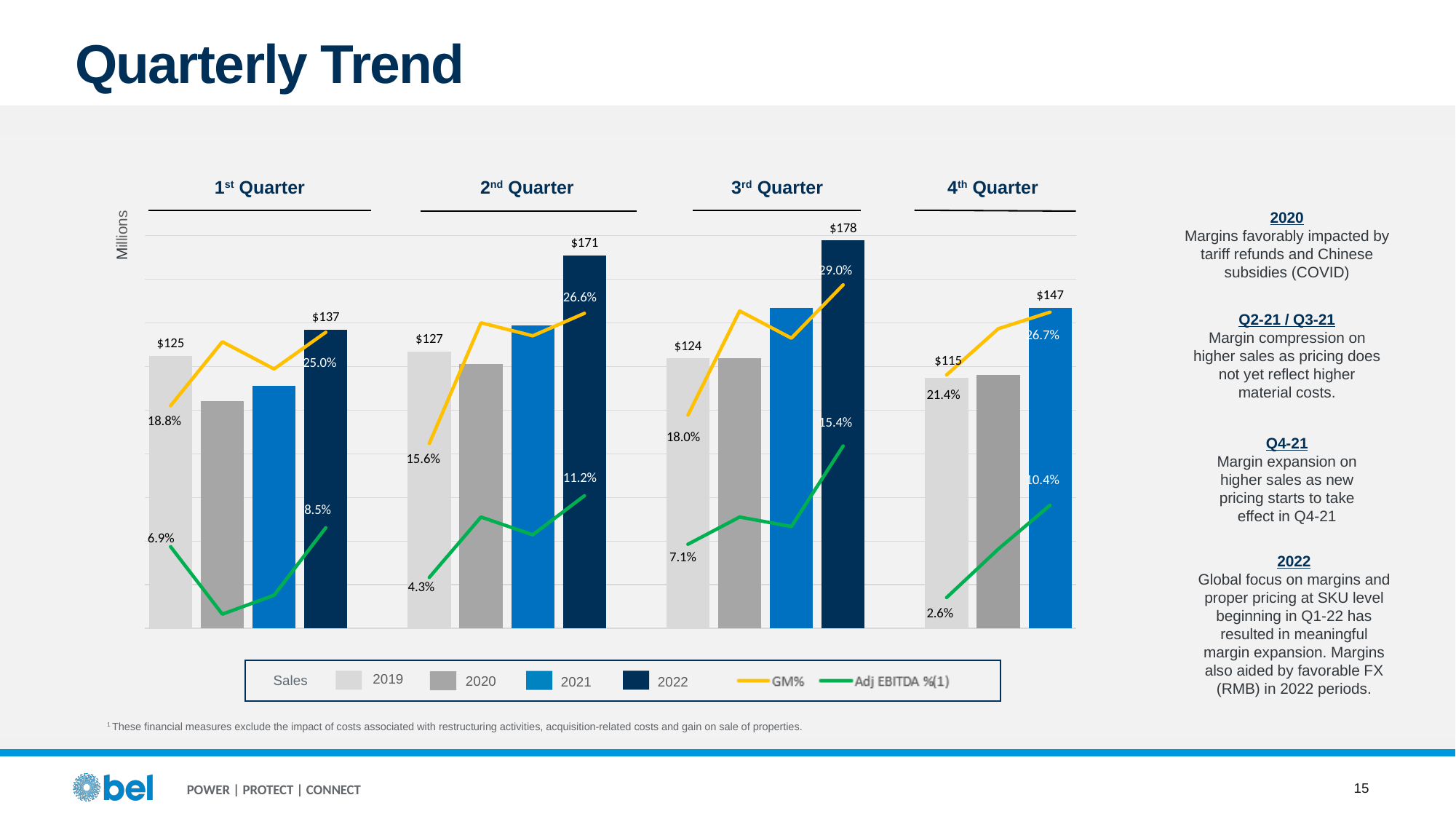
In the 2nd Quarter chart, what is the GM% value labelled on the 2022 bar? 26.6% In the 2nd Quarter chart, what is the difference between the 2022 sales ($171) and the 2019 sales ($127)? $44 How many entries does the legend list in total? 6 In the 3rd Quarter chart, what is the 2019 sales value? $124 Across all four quarter charts, which labelled sales value is the highest? $178 (3rd Quarter, 2022) How many sales bars are shown in the 4th Quarter chart? 3 In the 3rd Quarter chart, does the GM% line rise or fall from 2019 to 2022? rise In the 1st Quarter chart, which is larger: the 2019 sales bar or the 2022 sales bar? 2022 In the 3rd Quarter chart, what is the Adj EBITDA % value labelled on the 2022 bar? 15.4% Across all four quarter charts, which labelled sales value is the lowest? $115 (4th Quarter, 2019) In the 1st Quarter chart, what is the 2022 sales value? $137 In the 4th Quarter chart, what is the Adj EBITDA % value labelled for 2019? 2.6%